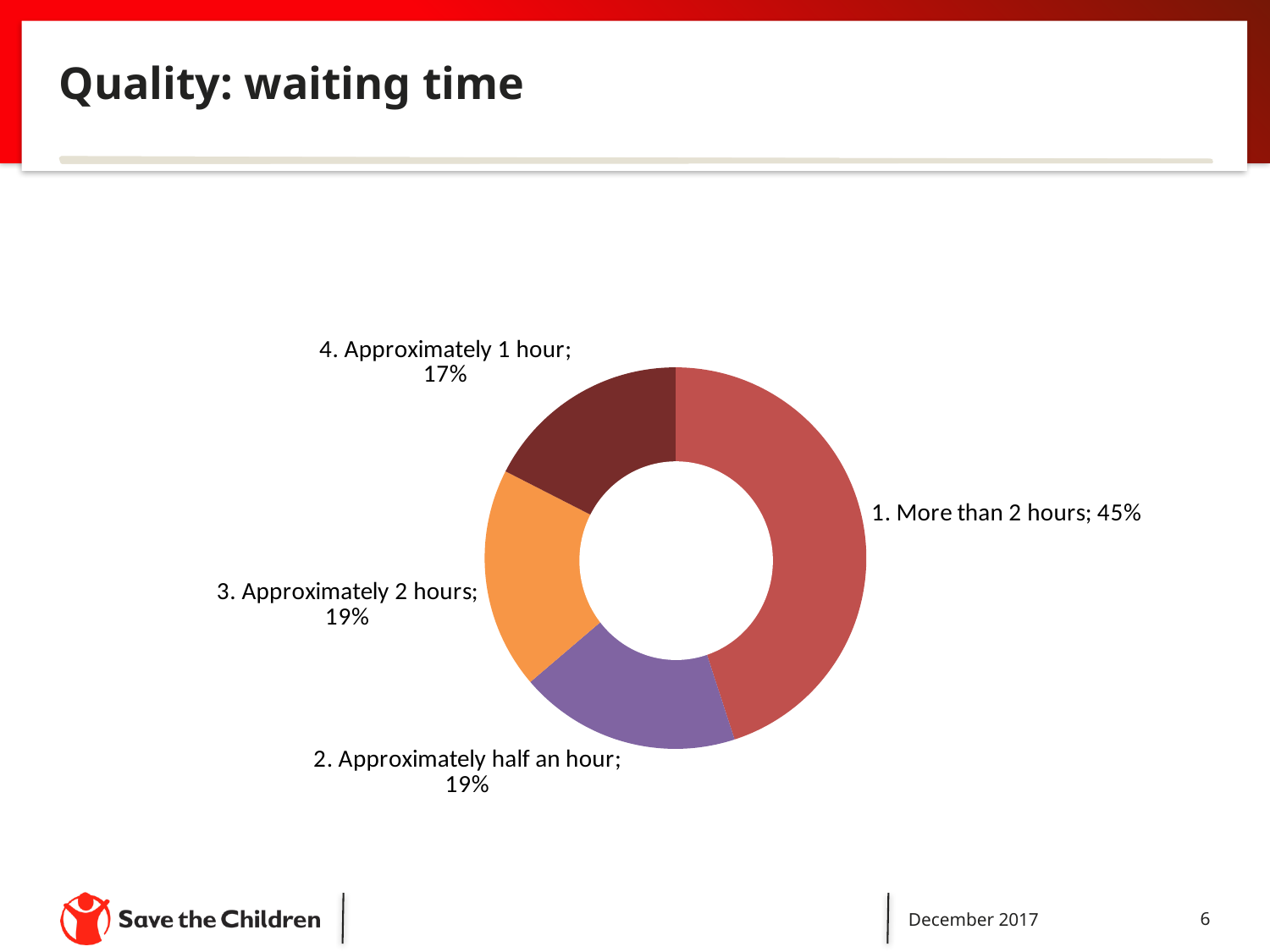
How many categories does the pie chart show? 4 What kind of chart is shown on the slide? Pie chart (doughnut) Which category has the smallest share of the pie? 4. Approximately 1 hour What share of the pie is labelled "2. Approximately half an hour"? 19% What is the title of the slide containing the chart? Quality: waiting time What share of the pie is labelled "4. Approximately 1 hour"? 17% What share of the pie is labelled "3. Approximately 2 hours"? 19% Which is larger: the share for "1. More than 2 hours" or the share for "3. Approximately 2 hours"? 1. More than 2 hours What share of the pie is labelled "1. More than 2 hours"? 45% What is the combined share of "2. Approximately half an hour" and "3. Approximately 2 hours"? 38% Which category has the largest share of the pie? 1. More than 2 hours What is the difference in percentage points between "1. More than 2 hours" and "4. Approximately 1 hour"? 28